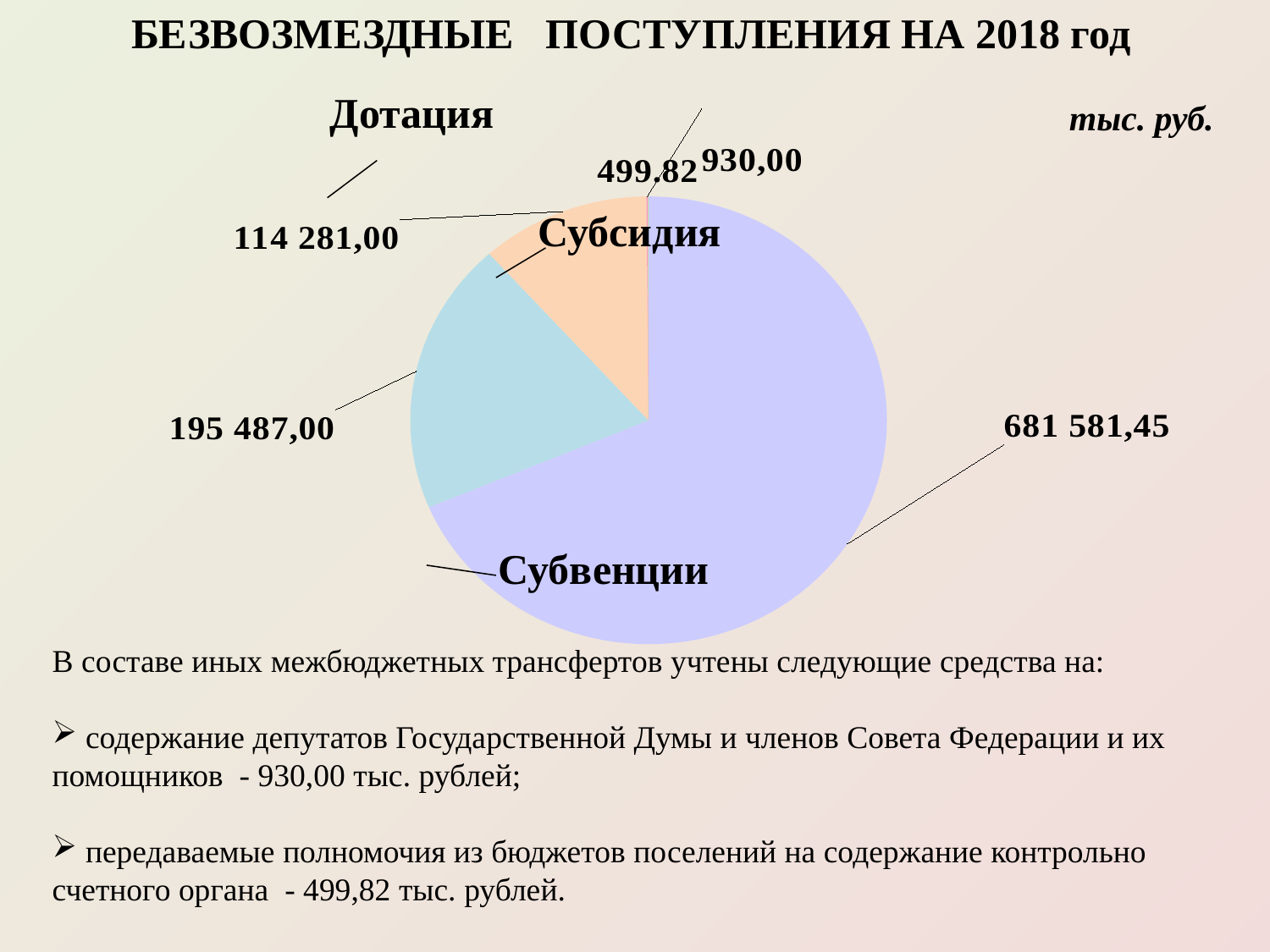
What is the title of the chart? БЕЗВОЗМЕЗДНЫЕ ПОСТУПЛЕНИЯ НА 2018 год What is the value of the Субвенции slice? 681 581,45 What kind of chart is shown on the slide? pie chart What is the value of the Субсидия slice? 114 281,00 How many values are labelled on the pie chart? 5 What is the difference between the value 195 487,00 and the Субсидия value 114 281,00? 81 206,00 In what units are the values on the chart given? тыс. руб. Which is larger: the Субвенции slice or the Субсидия slice? Субвенции Which slice of the pie is the largest? Субвенции What is the smallest value labelled on the pie chart? 499.82 What is the difference between the Субвенции value (681 581,45) and the value 195 487,00? 486 094,45 What is the value of the light blue slice labelled 195 487,00? 195 487,00